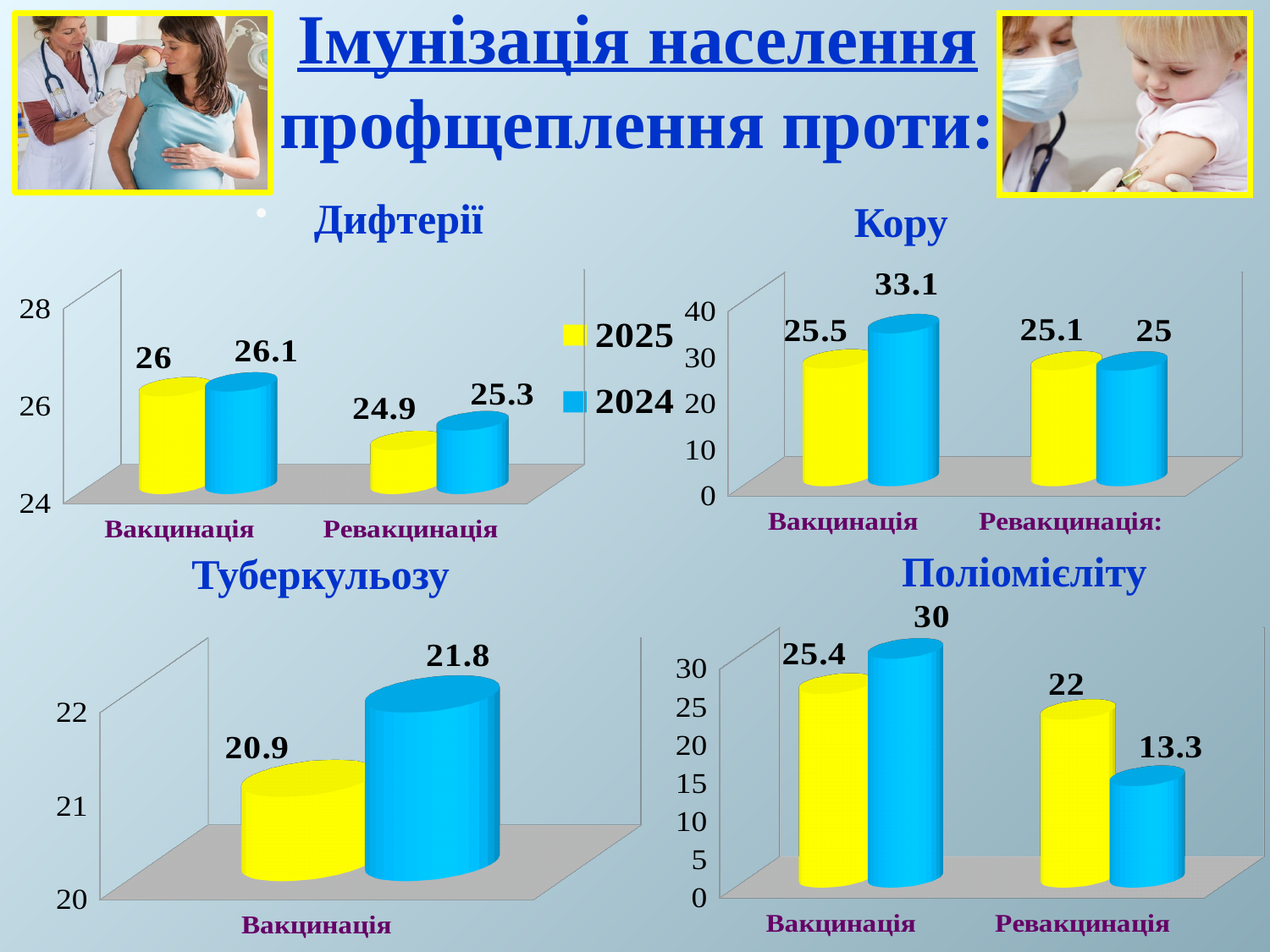
In the "Туберкульозу" chart, what is the value for 2025 in the Вакцинація category? 20.9 In the "Дифтерії" chart, what is the value for 2025 in the Ревакцинація category? 24.9 How many categories are shown on the x axis of the "Дифтерії" chart? 2 In the "Кору" chart, what is the difference between the 2024 and 2025 values for Вакцинація? 7.6 What kind of chart is the "Кору" chart? Bar chart In the "Поліомієліту" chart, which bar is the highest? 2024 Вакцинація In the "Туберкульозу" chart, what is the difference between the 2024 and 2025 values for Вакцинація? 0.9 In the "Поліомієліту" chart, which bar is the lowest? 2024 Ревакцинація In the "Кору" chart, what is the value for 2024 in the Вакцинація category? 33.1 How many series does the legend list? 2 In the "Поліомієліту" chart, which is larger for Ревакцинація: the 2025 value or the 2024 value? 2025 In the "Поліомієліту" chart, what is the value for 2024 in the Ревакцинація category? 13.3